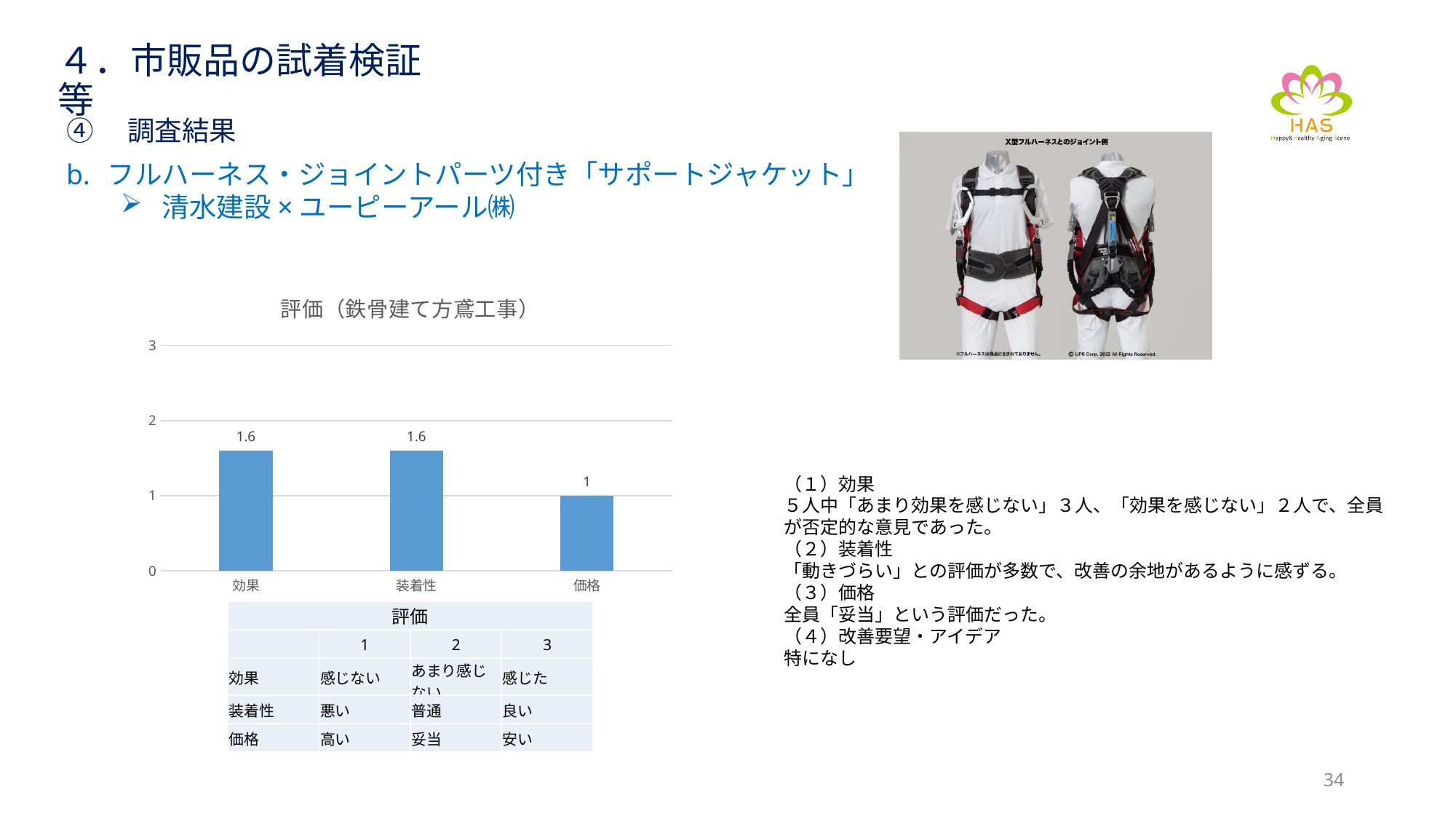
What is the difference between the values for 効果 and 価格? 0.6 What kind of chart is shown on the slide? bar chart Which is larger, the value for 装着性 or the value for 価格? 装着性 What is the value for 効果 in the chart? 1.6 What is the maximum value shown on the y axis of the chart? 3 Do the values for 効果 and 装着性 differ in the chart? No, both are 1.6 Is the value for 効果 greater or less than 2? less Which category has the lowest value in the chart? 価格 How many categories are shown on the x axis of the chart? 3 What is the value for 価格 in the chart? 1 What is the value for 装着性 in the chart? 1.6 What is the title of the chart? 評価（鉄骨建て方鳶工事）